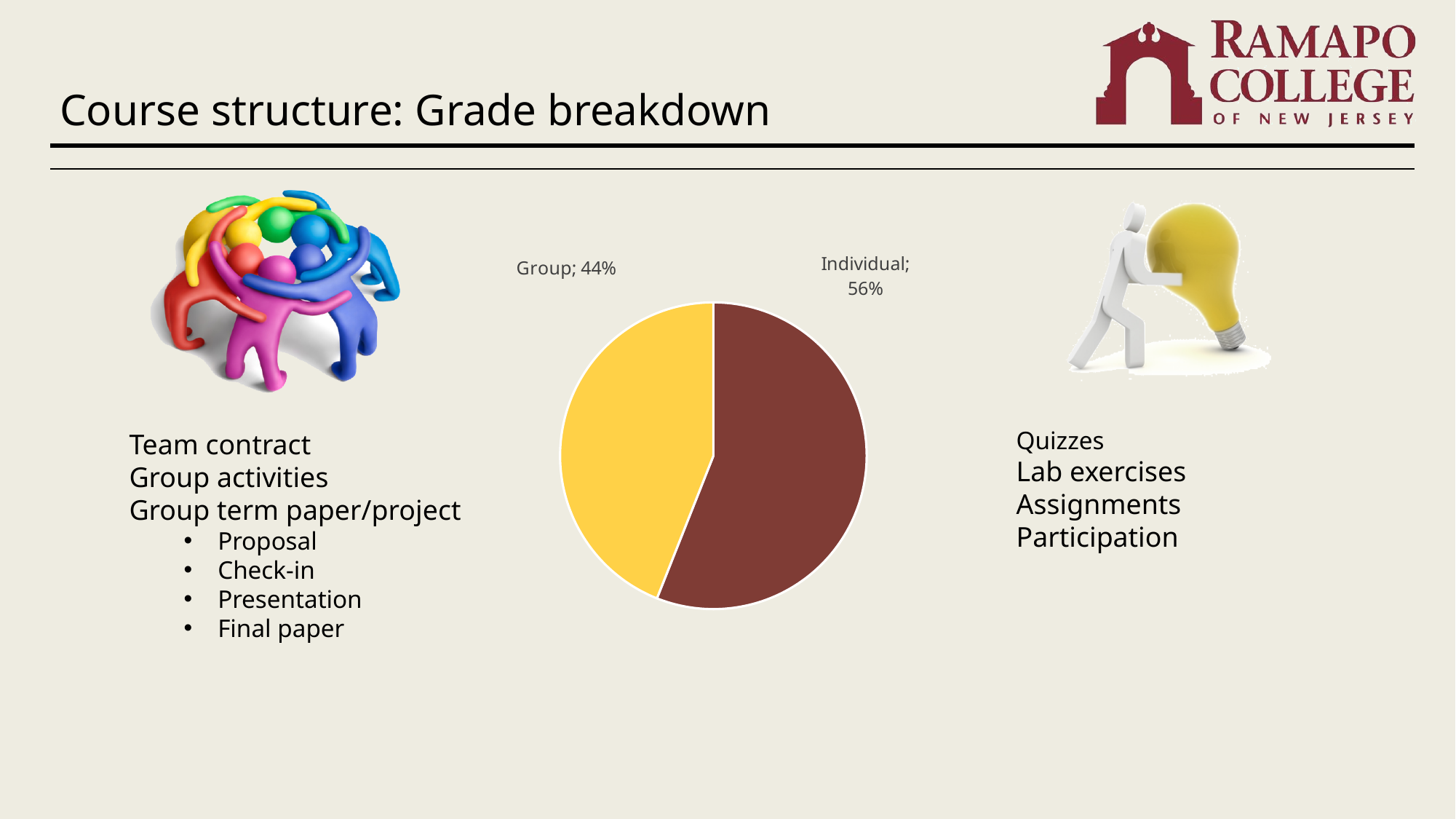
Which category has the smallest share of the pie? Group What kind of chart is shown on the slide? pie chart What colour is the Individual slice of the pie? dark red Which category has the largest share of the pie? Individual What is the difference in percentage points between the Individual and Group shares? 12 Is the Group share greater or less than 50%? less What share of the grade is Individual work? 56% What colour is the Group slice of the pie? yellow What share of the grade is Group work? 44% How many slices does the pie chart have? 2 Which slice of the pie is larger, Group or Individual? Individual